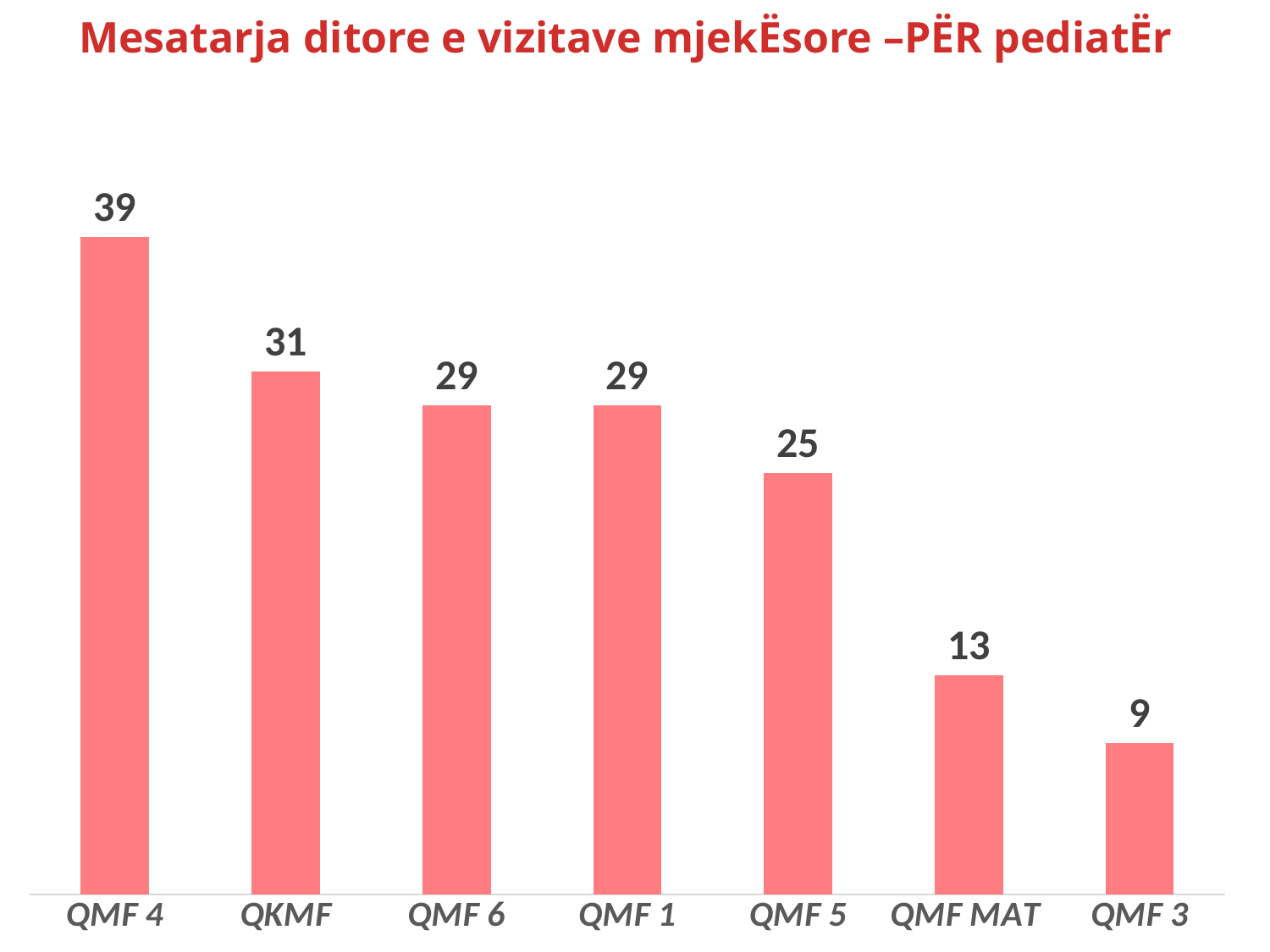
Which category has the highest value? QMF 4 Which is larger, the value for QMF 5 or the value for QMF MAT? QMF 5 What kind of chart is shown on the slide? Bar chart What is the value for QMF 4? 39 Which category has the lowest value? QMF 3 What is the difference between the values for QKMF and QMF 5? 6 What is the difference between the values for QMF 4 and QMF 3? 30 How many categories are shown in the chart? 7 What is the value for QKMF? 31 What is the value for QMF 5? 25 Do the values rise or fall from left to right along the x axis? Fall What is the value for QMF MAT? 13